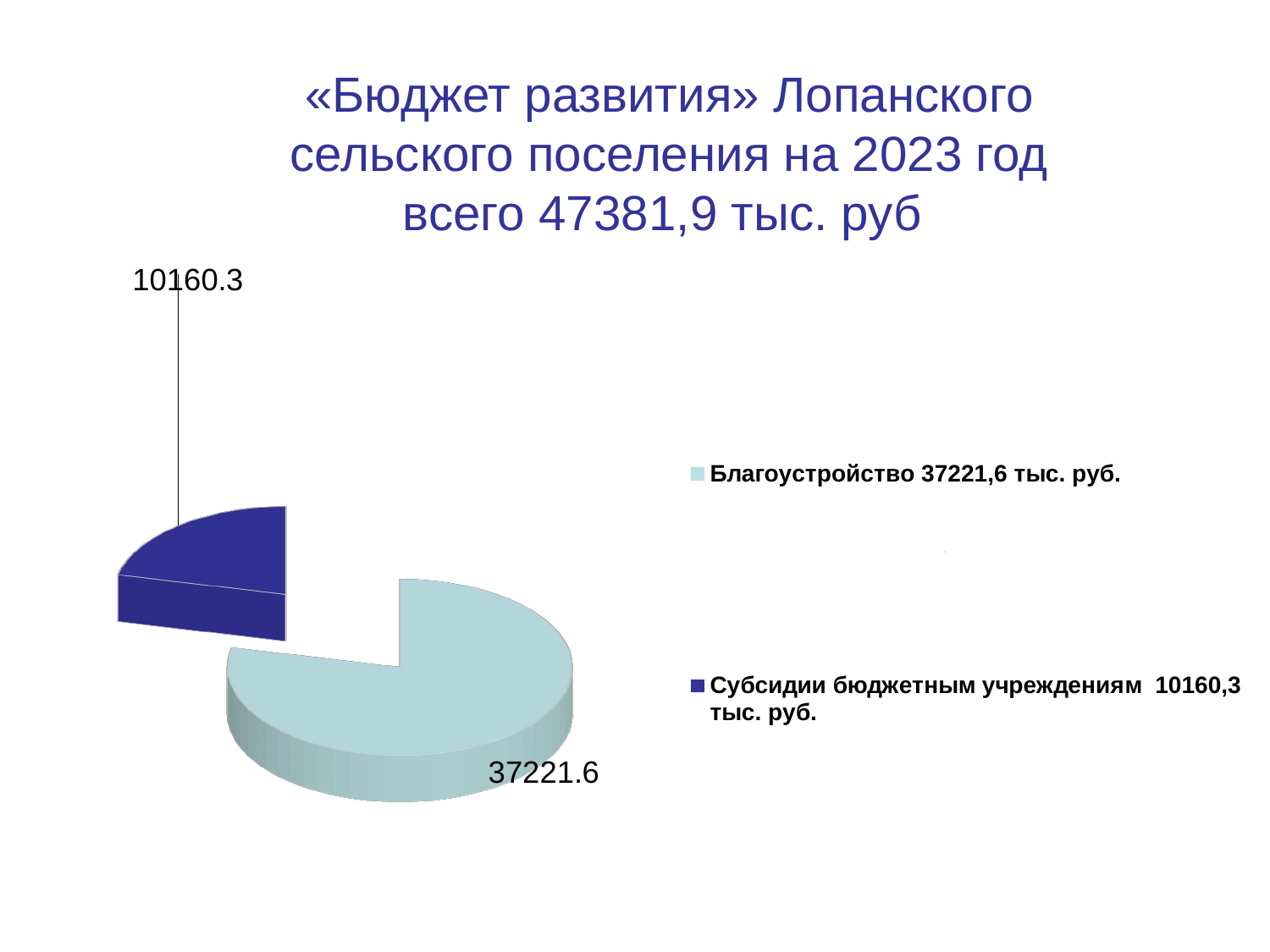
What is the total of the two slices in the pie chart? 47381.9 How many entries does the legend list? 2 Which is larger: Благоустройство or Субсидии бюджетным учреждениям? Благоустройство What is the difference between the values for Благоустройство and Субсидии бюджетным учреждениям? 27061.3 Which category has the largest slice of the pie? Благоустройство How many slices does the pie chart have? 2 What kind of chart is shown on the slide? pie chart What colour is the slice for Субсидии бюджетным учреждениям? dark blue What is the value for Благоустройство? 37221.6 What total amount is stated in the slide title? 47381,9 тыс. руб Which category has the smallest slice of the pie? Субсидии бюджетным учреждениям What is the value for Субсидии бюджетным учреждениям? 10160.3